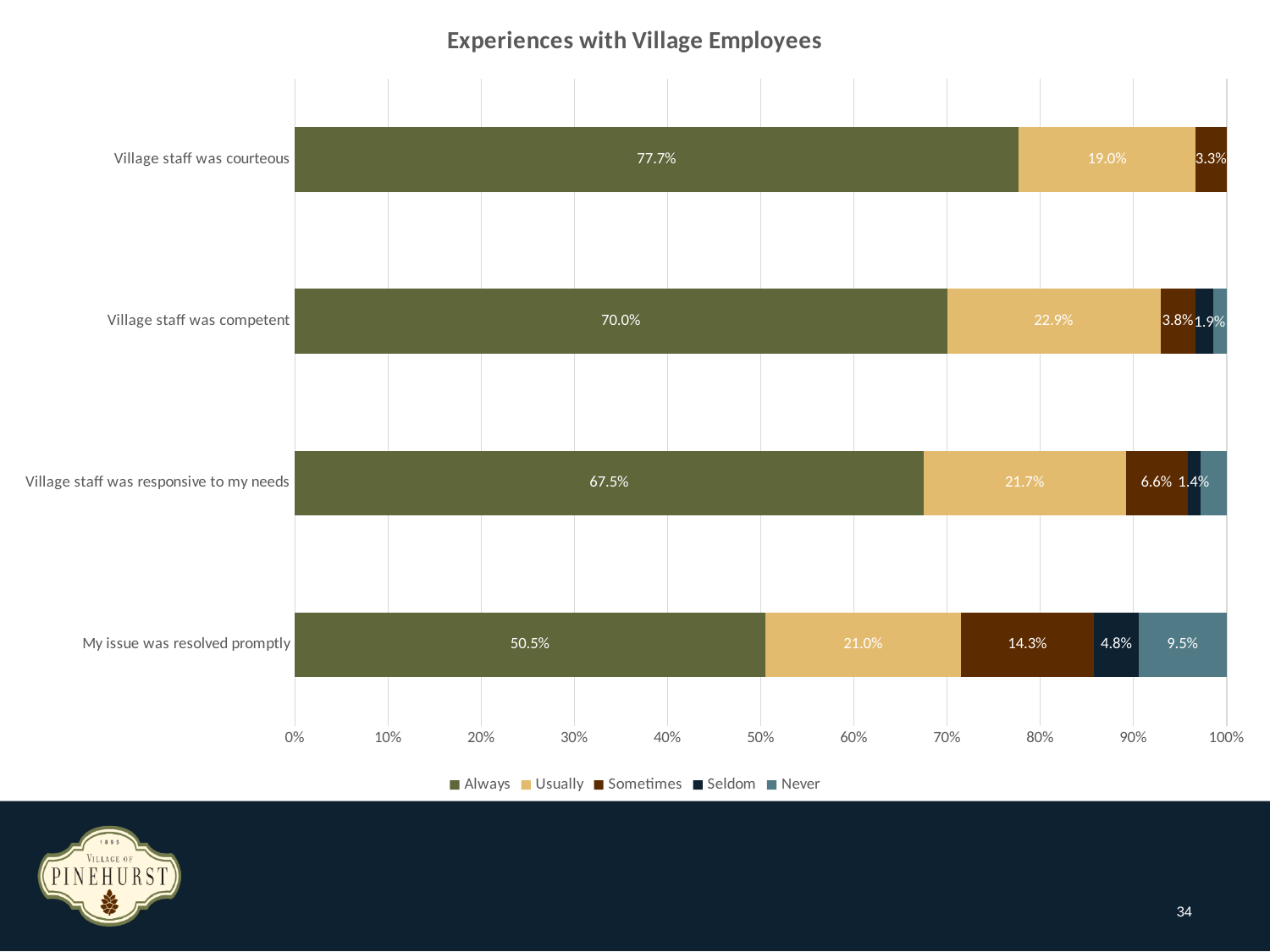
What is the 'Never' value for 'My issue was resolved promptly'? 9.5% What type of chart is shown on the slide? Stacked bar chart What is the 'Sometimes' value for 'Village staff was competent'? 3.8% How many series does the legend list? 5 Which has the larger 'Usually' value: 'Village staff was competent' or 'Village staff was responsive to my needs'? Village staff was competent What is the difference between the 'Always' values for 'Village staff was courteous' and 'My issue was resolved promptly'? 27.2 percentage points What is the 'Seldom' value for 'My issue was resolved promptly'? 4.8% What percentage of respondents said village staff was 'Always' courteous? 77.7% How many statements (categories) are shown in the chart? 4 Which statement has the highest 'Always' percentage? Village staff was courteous Which statement has the lowest 'Always' percentage? My issue was resolved promptly What is the 'Usually' value for 'Village staff was courteous'? 19.0%